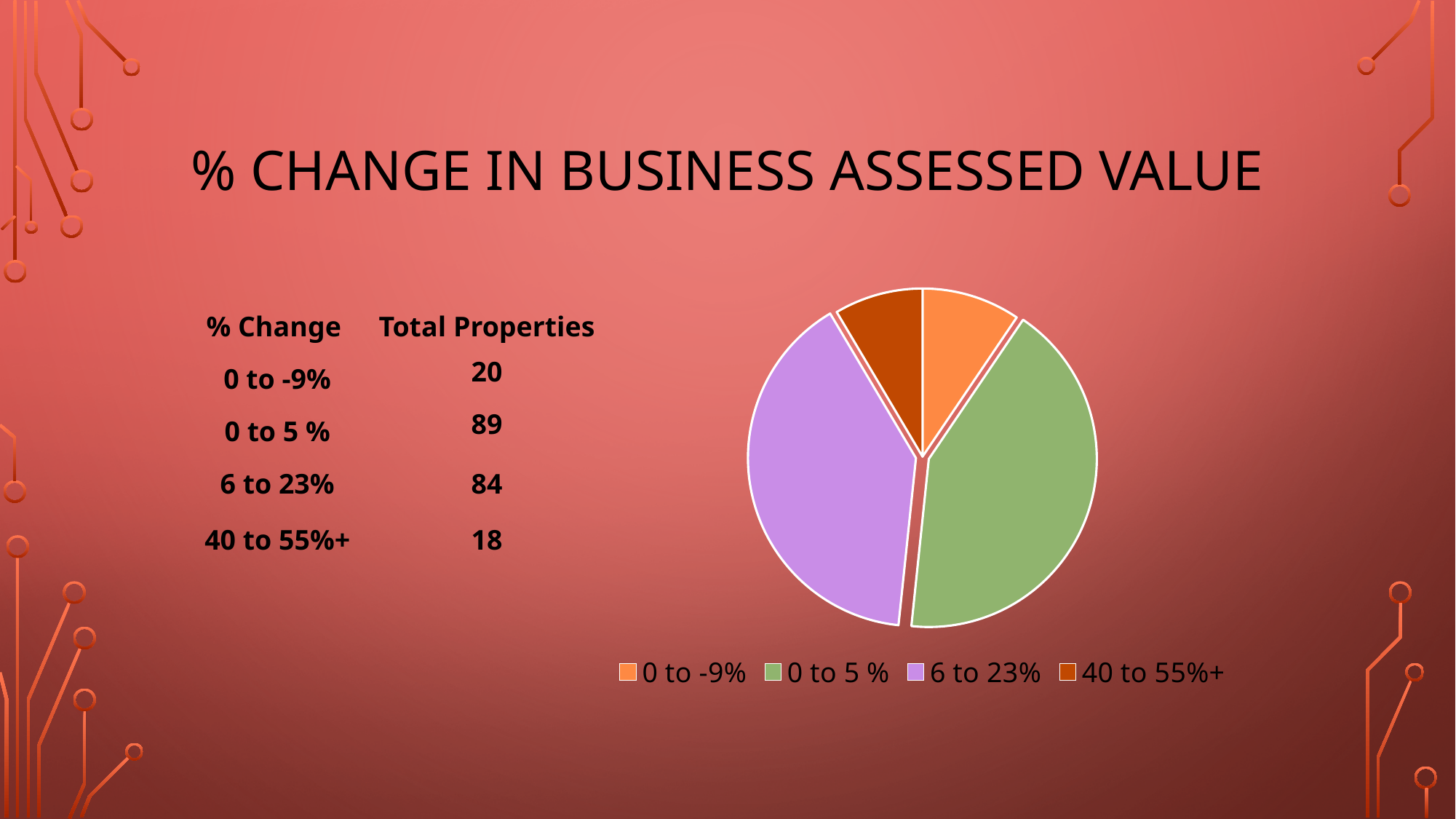
How many entries does the legend of the pie chart list? 4 What is the total number of properties across all four categories shown? 211 How many slices does the pie chart have? 4 What is the difference in total properties between the 0 to 5 % category and the 6 to 23% category? 5 Which % change category has the smallest number of total properties? 40 to 55%+ What kind of chart is shown on the slide? pie chart According to the table on the slide, how many total properties are in the 0 to 5 % category? 89 What is the title of the slide containing the pie chart? % Change in Business Assessed Value According to the table on the slide, how many total properties are in the 6 to 23% category? 84 Which % change category has the largest number of total properties? 0 to 5 % According to the table on the slide, how many total properties are in the 0 to -9% category? 20 According to the table on the slide, how many total properties are in the 40 to 55%+ category? 18